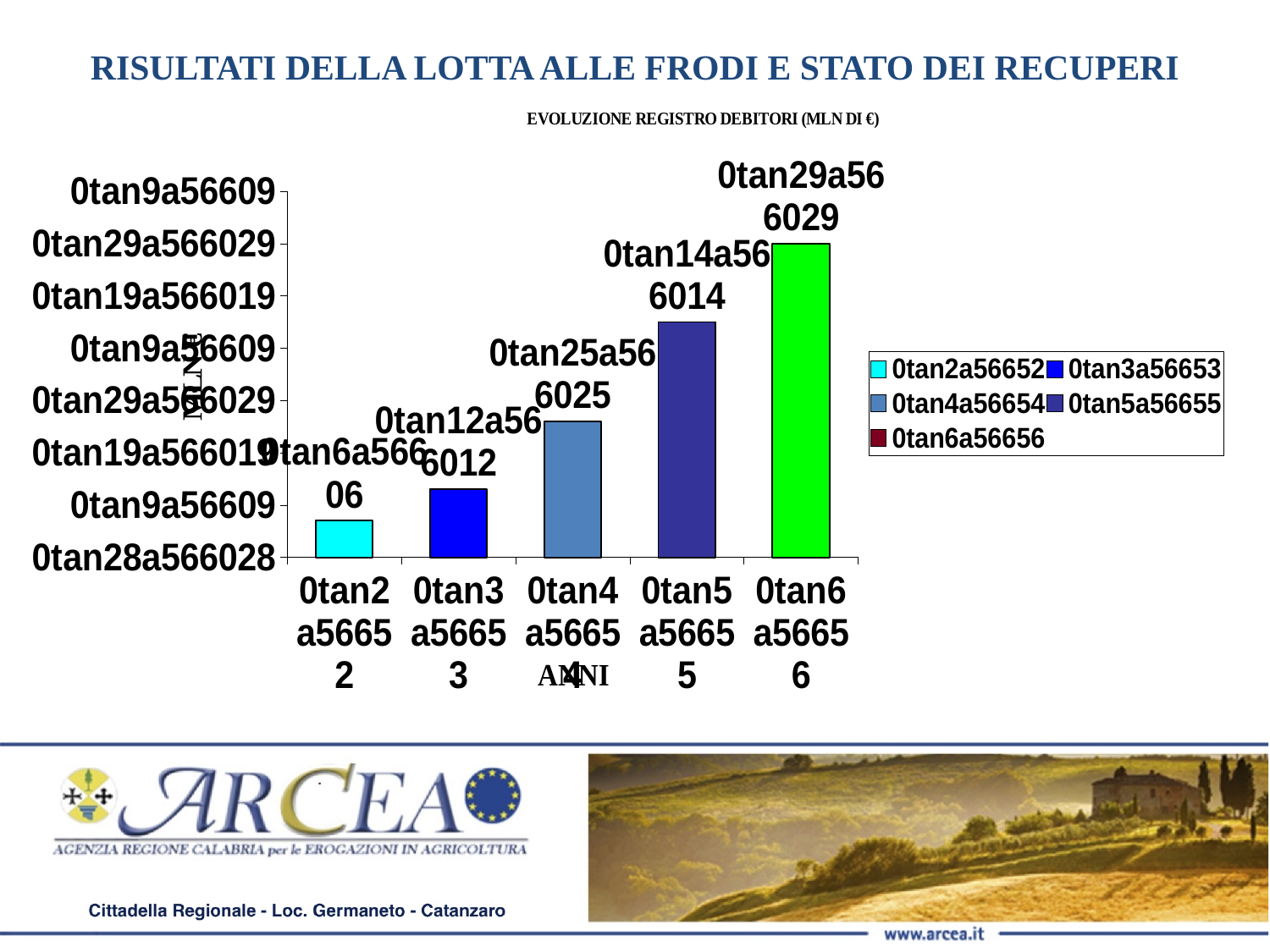
What colour is the tallest bar in the chart? green What kind of chart is shown on the slide? bar chart Which bar is the tallest in the chart, by position? the rightmost bar Is the second bar from the left taller or shorter than the rightmost bar? shorter Which bar is the shortest in the chart, by position? the leftmost bar Is the fourth bar from the left taller or shorter than the third bar from the left? taller What is the title of the chart? EVOLUZIONE REGISTRO DEBITORI (MLN DI €) How many entries does the chart's legend list? 5 Do the bar values rise or fall from left to right along the x axis? rise What is the label of the x axis of the chart? ANNI How many bars are plotted in the chart? 5